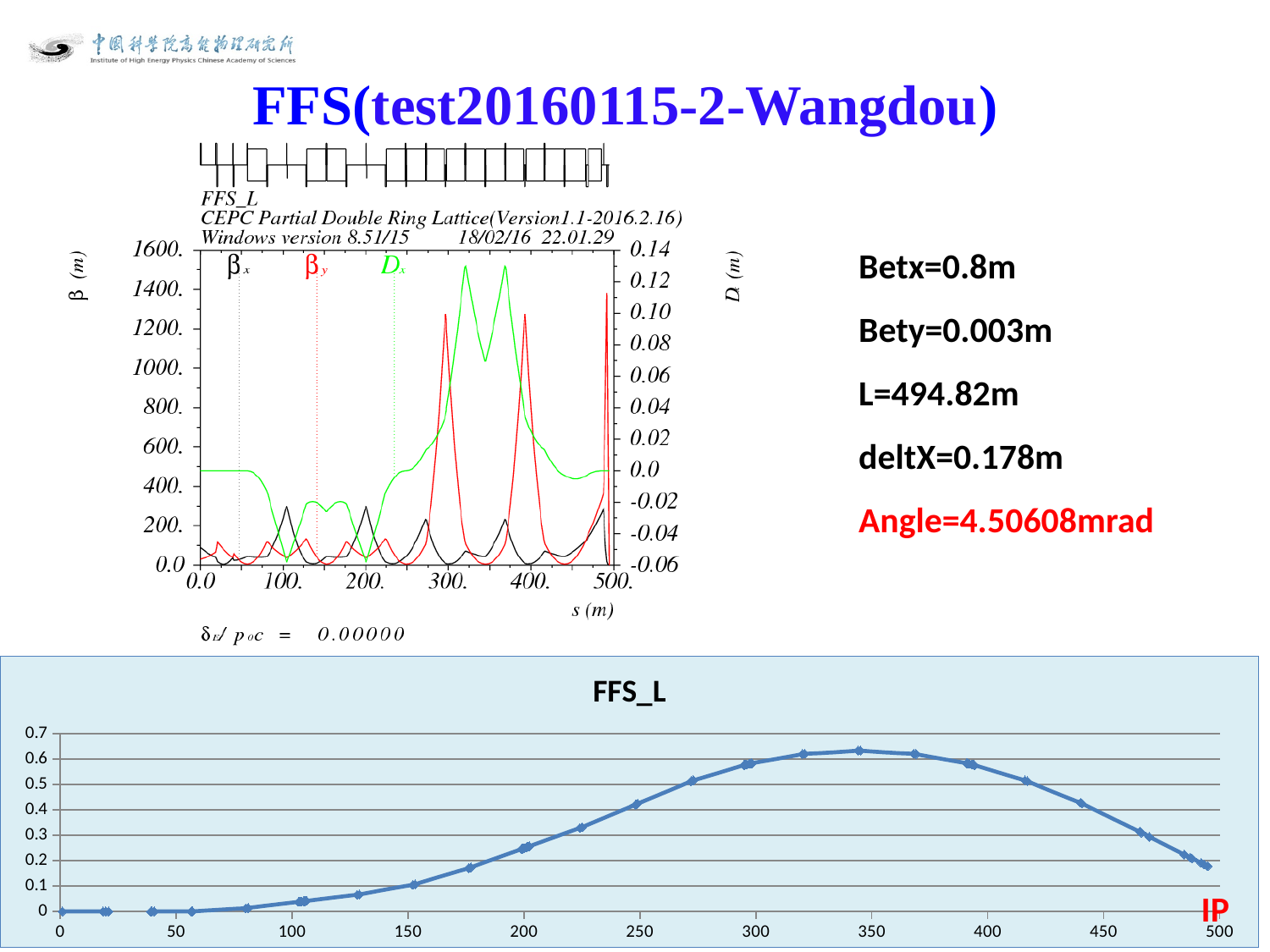
In the top lattice chart, which series reaches the highest value on the left β (m) axis, βx or βy? βy What is the title of the bottom chart? FFS_L How many series does the legend of the top lattice chart list? 3 In the bottom chart titled FFS_L, is the value at x = 0 greater or less than 0.1? less What type of chart is the bottom chart titled FFS_L? line chart In the bottom chart titled FFS_L, is the value at x = 250 larger or smaller than the value at x = 450? larger In the top lattice chart, is the peak value of βy near s = 490 greater or less than 1200 on the left axis? greater In the top lattice chart, what colour is the Dx curve? green In the bottom chart titled FFS_L, is the value at x = 345 greater or less than 0.5? greater In the bottom chart titled FFS_L, does the curve rise or fall between x = 400 and x = 500? fall In the bottom chart titled FFS_L, does the curve rise or fall between x = 100 and x = 300? rise